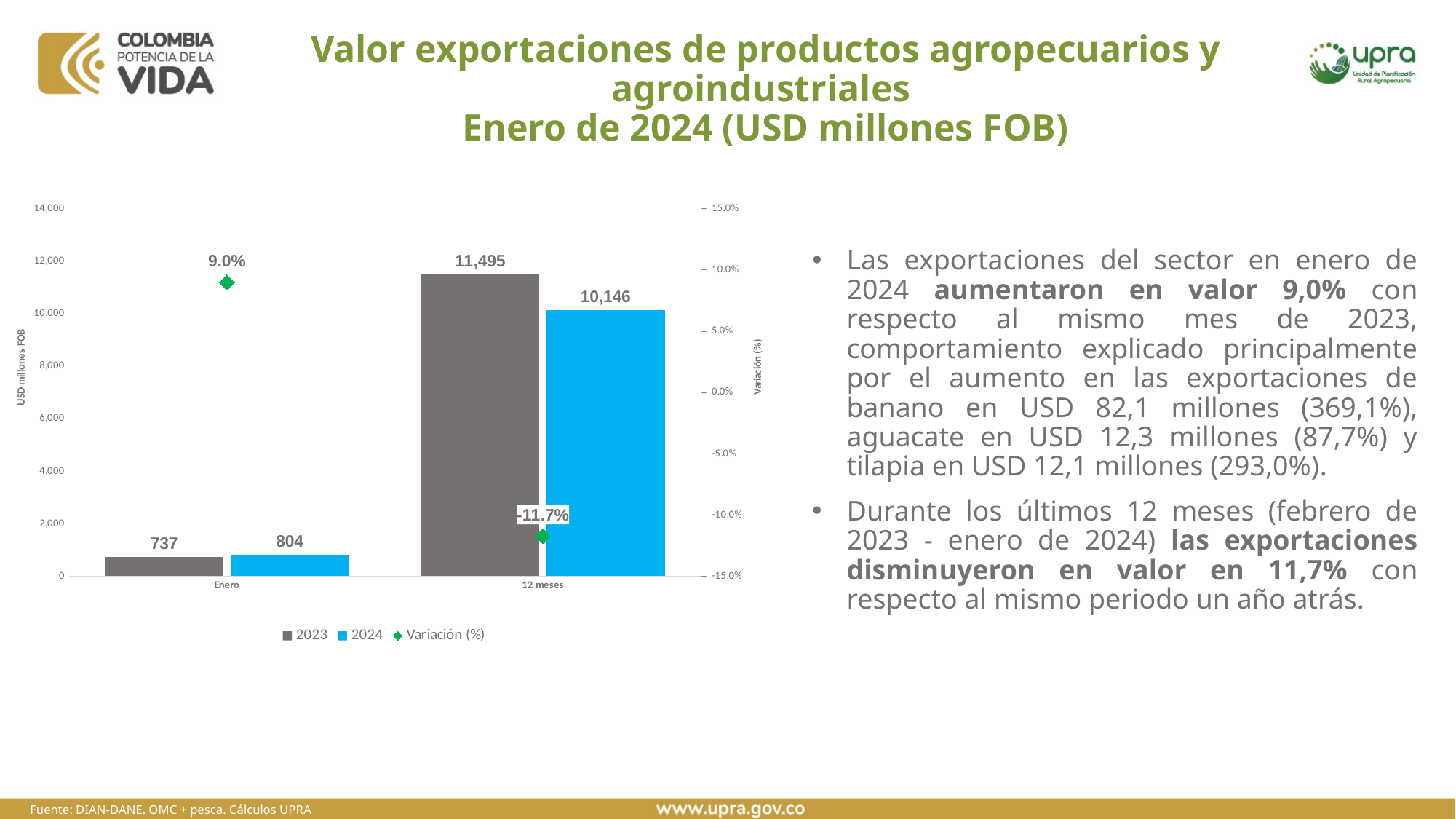
Which is larger for 12 meses, the 2023 value or the 2024 value? 2023 How many categories are shown on the x axis? 2 What is the value for 2024 in the 12 meses category? 10,146 What is the difference between the 2024 and 2023 values for Enero? 67 What colour are the 2024 bars? Blue What is the value for 2023 in the 12 meses category? 11,495 How many series does the legend list? 3 What is the difference between the 2023 and 2024 values for 12 meses? 1,349 What is the value for 2024 in the Enero category? 804 What is the Variación (%) value for 12 meses? -11.7% What is the Variación (%) value for Enero? 9.0% What is the value for 2023 in the Enero category? 737